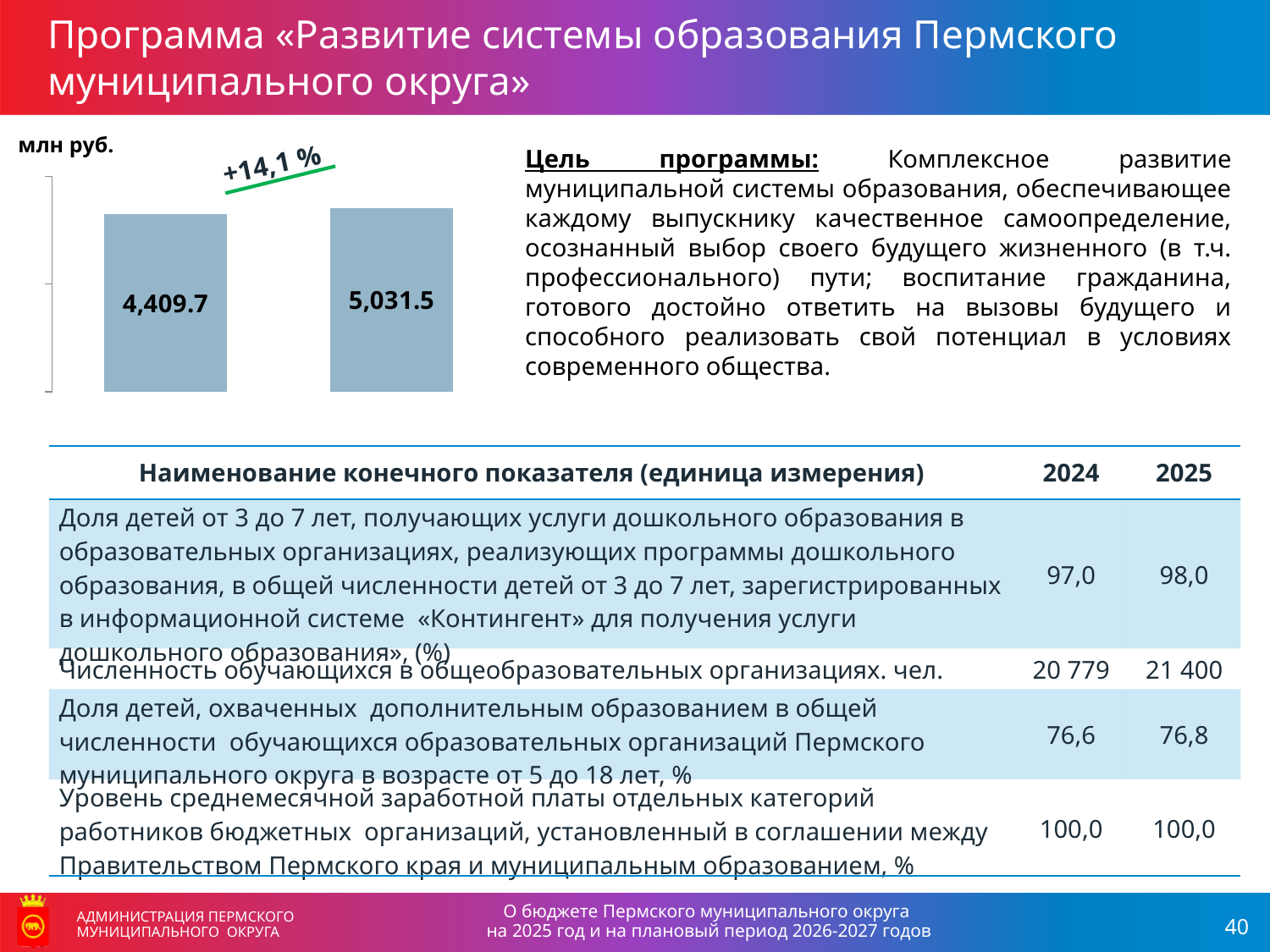
What is the difference between the right bar and the left bar in the chart? 621.8 In what units are the values in the chart expressed? млн руб. How many bars are plotted in the chart? 2 What is the value of the right bar in the chart? 5,031.5 What is the value of the left bar in the chart? 4,409.7 What percentage change is annotated above the bars in the chart? +14,1 % Which bar in the chart has the lowest value? the left bar (4,409.7) What type of chart is shown on the slide? bar chart Is the value of the left bar larger or smaller than the value of the right bar? smaller Which bar in the chart is taller, the left or the right one? the right one Do the values in the chart rise or fall from left to right? rise